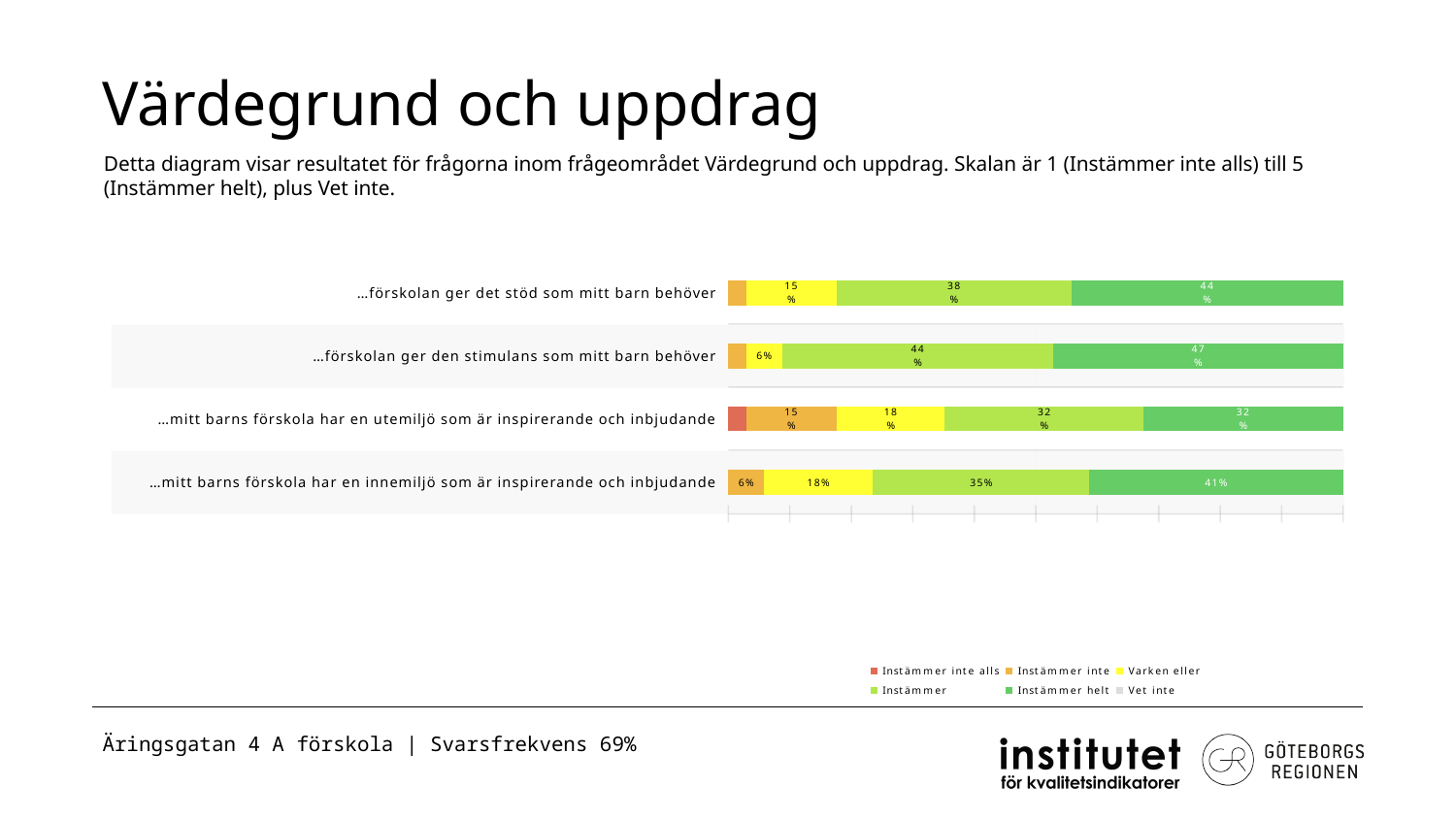
Which is larger: the Instämmer value for "...förskolan ger den stimulans som mitt barn behöver" or for "...förskolan ger det stöd som mitt barn behöver"? ...förskolan ger den stimulans som mitt barn behöver What is the Varken eller value for "...mitt barns förskola har en utemiljö som är inspirerande och inbjudande"? 18% How many question categories are plotted in the chart? 4 Which category has the lowest Instämmer helt value? ...mitt barns förskola har en utemiljö som är inspirerande och inbjudande Which category has the highest Instämmer helt value? ...förskolan ger den stimulans som mitt barn behöver What is the difference between the Instämmer helt values for "...förskolan ger den stimulans som mitt barn behöver" and "...förskolan ger det stöd som mitt barn behöver"? 3% What type of chart is shown on the slide? Stacked bar chart What is the Instämmer inte value for "...mitt barns förskola har en innemiljö som är inspirerande och inbjudande"? 6% What is the Instämmer value for "...mitt barns förskola har en innemiljö som är inspirerande och inbjudande"? 35% What is the Instämmer helt value for "...förskolan ger det stöd som mitt barn behöver"? 44% What is the Instämmer helt value for "...förskolan ger den stimulans som mitt barn behöver"? 47% How many series does the legend list? 6